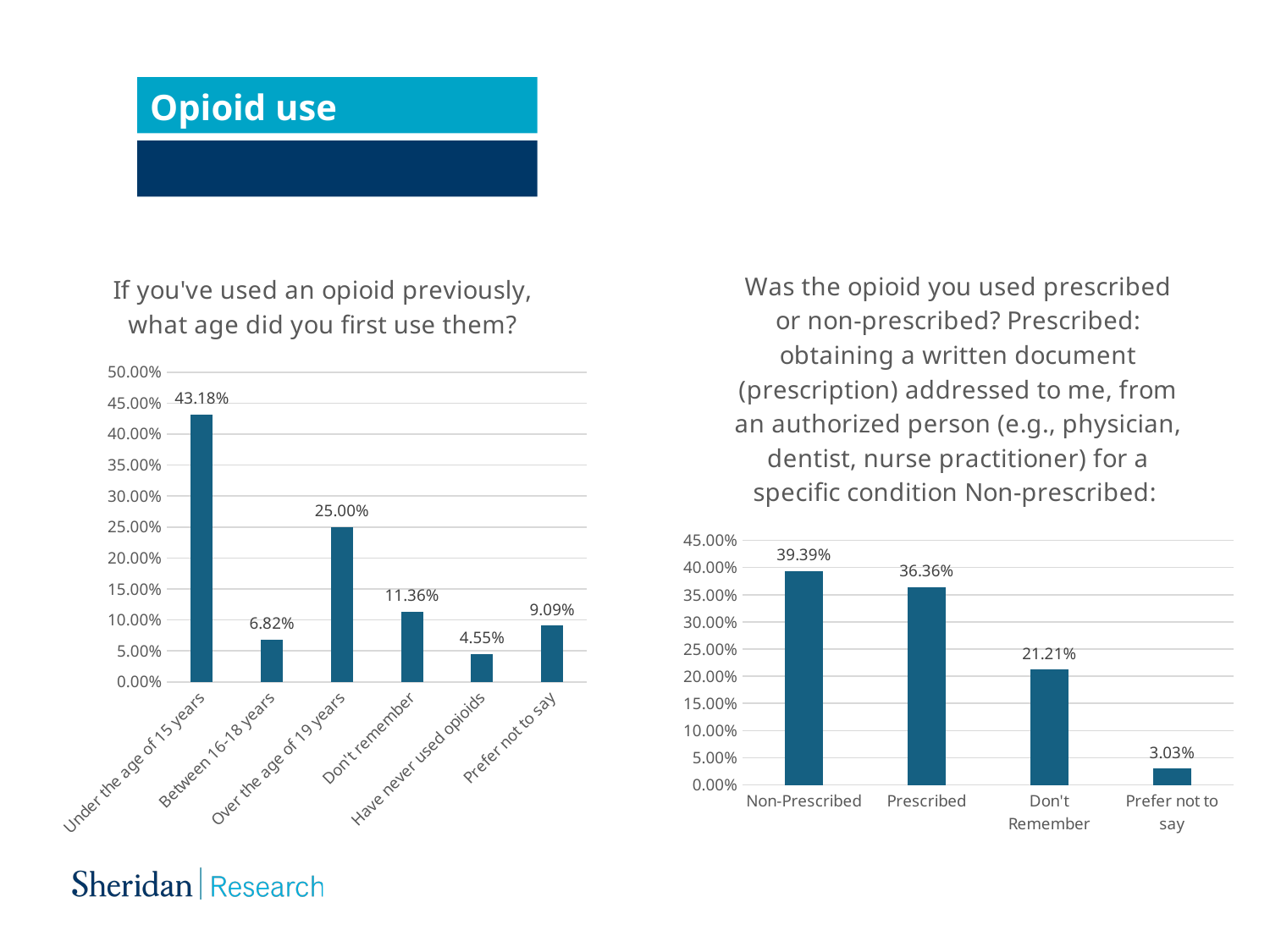
In the right chart (prescribed or non-prescribed), what is the value for 'Prefer not to say'? 3.03% In the right chart (prescribed or non-prescribed), what is the difference between 'Non-Prescribed' and 'Don't Remember'? 18.18% In the right chart (prescribed or non-prescribed), what is the value for 'Prescribed'? 36.36% In the left chart (age of first opioid use), what is the value for 'Over the age of 19 years'? 25.00% In the left chart (age of first opioid use), what is the value for 'Under the age of 15 years'? 43.18% In the left chart (age of first opioid use), what is the difference between 'Don't remember' and 'Between 16-18 years'? 4.54% In the right chart (prescribed or non-prescribed), which is larger: 'Non-Prescribed' or 'Prescribed'? Non-Prescribed In the right chart (prescribed or non-prescribed), do the values rise or fall from left to right along the x axis? fall In the left chart (age of first opioid use), which category has the lowest value? Have never used opioids In the left chart (age of first opioid use), which category has the highest value? Under the age of 15 years What kind of chart is the right chart (prescribed or non-prescribed)? bar chart In the left chart (age of first opioid use), how many categories are shown on the x axis? 6